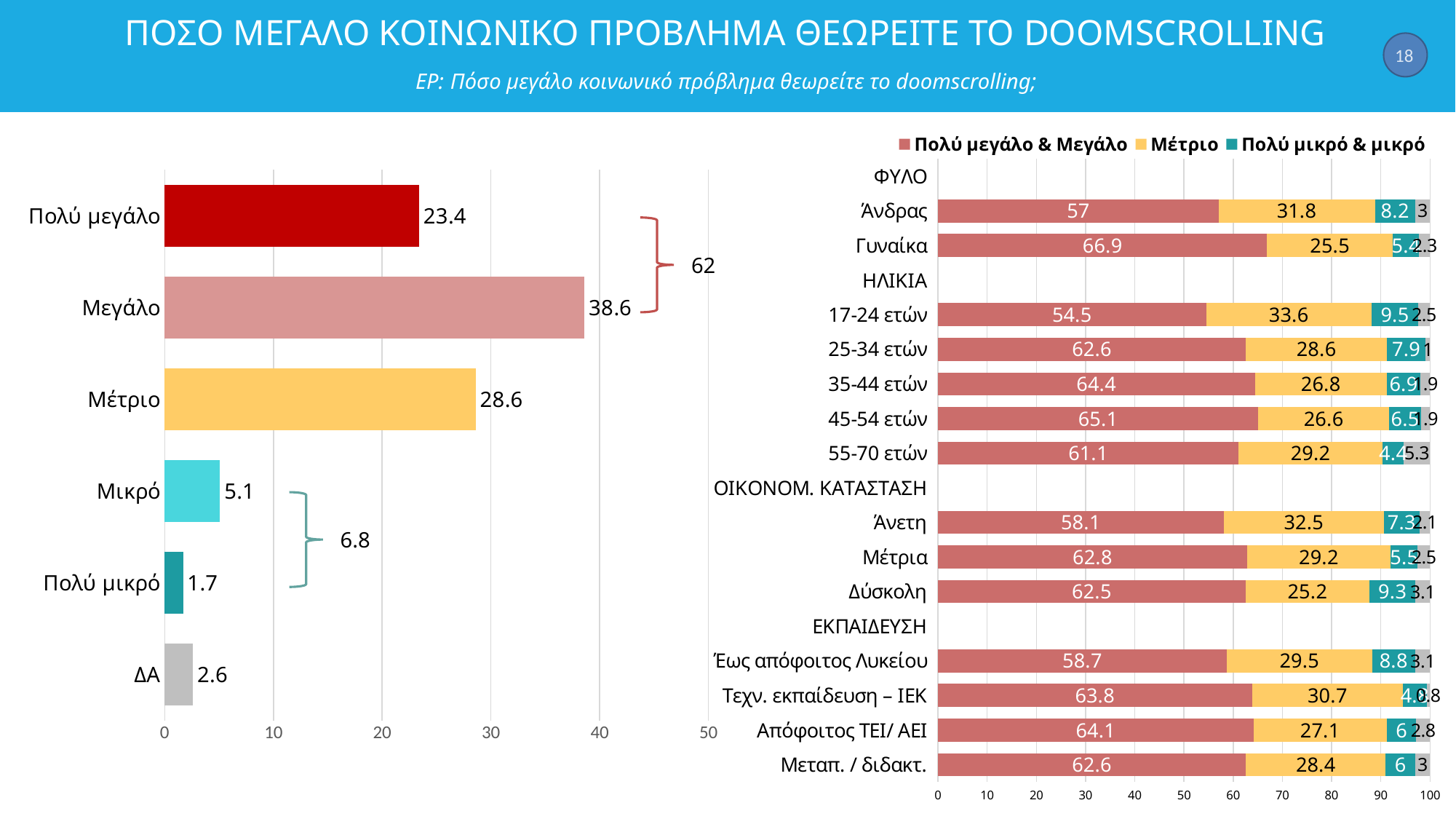
On the right stacked bar chart, which has the larger Πολύ μεγάλο & Μεγάλο value, Άνδρας or Γυναίκα? Γυναίκα How many categories are shown on the left bar chart? 6 On the left bar chart, what combined value does the bracket next to Πολύ μεγάλο and Μεγάλο show? 62 On the right stacked bar chart, what is the difference between the Μέτριο values for Άνδρας and Γυναίκα? 6.3 On the right stacked bar chart, what is the Πολύ μεγάλο & Μεγάλο value for Γυναίκα? 66.9 On the left bar chart, which category has the lowest value? Πολύ μικρό What kind of chart is the chart on the left of the slide? Bar chart On the left bar chart, what is the value for Μεγάλο? 38.6 On the left bar chart, what is the difference between the values for Μεγάλο and Πολύ μεγάλο? 15.2 On the left bar chart, which category has the highest value? Μεγάλο How many series does the legend of the right stacked bar chart list? 3 On the right stacked bar chart, what is the Μέτριο value for 17-24 ετών? 33.6